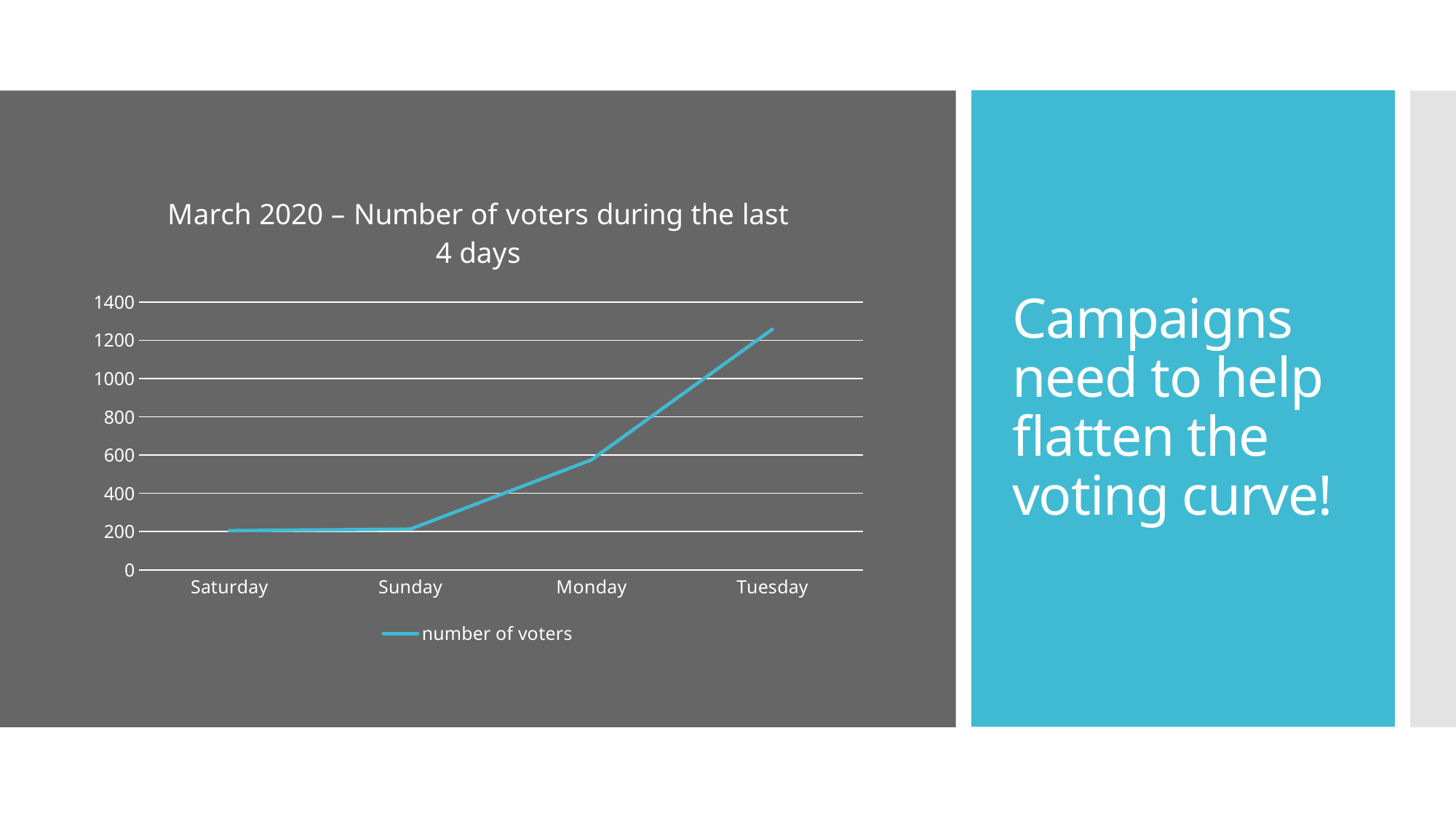
What is the title of the chart? March 2020 – Number of voters during the last 4 days Is the number of voters on Monday greater or less than 800? less What kind of chart is shown on the slide? line chart What is the name of the series shown in the legend? number of voters Is the number of voters on Tuesday greater or less than 1200? greater Do the number of voters rise or fall from Saturday to Tuesday? rise How many series does the legend list? 1 Which day has more voters, Monday or Tuesday? Tuesday How many days are plotted along the x axis? 4 Is the number of voters on Saturday greater or less than 400? less Which day has the highest number of voters? Tuesday